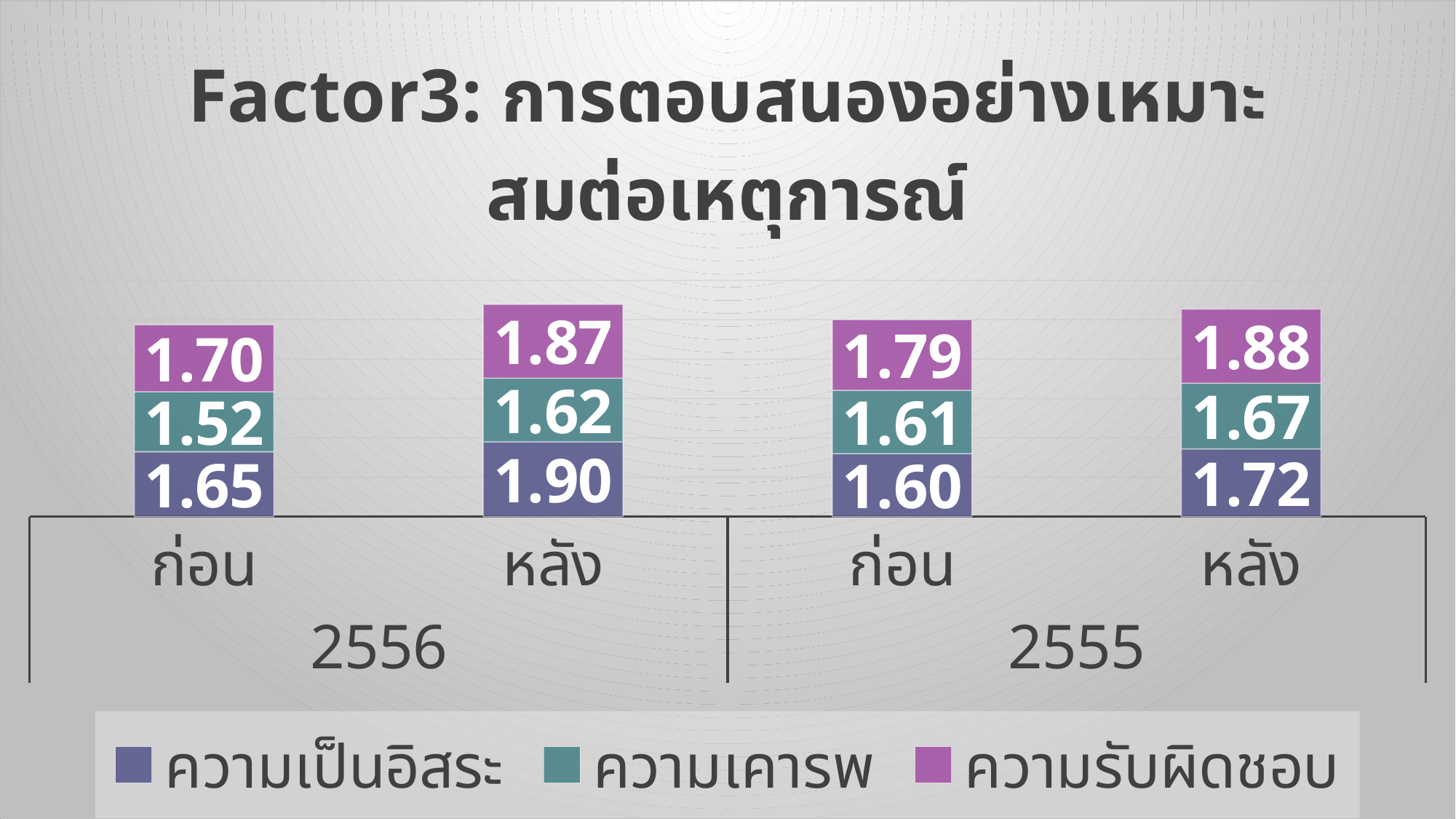
What is the difference between the ความเป็นอิสระ values for หลัง and ก่อน in 2556? 0.25 How many stacked bars are plotted in the chart? 4 What is the value of ความรับผิดชอบ for ก่อน in 2556? 1.70 What is the value of ความรับผิดชอบ for หลัง in 2555? 1.88 How many series does the legend list? 3 Which category has the lowest value for ความเคารพ? ก่อน 2556 What is the value of ความเป็นอิสระ for หลัง in 2556? 1.90 Which category has the highest value for ความเป็นอิสระ? หลัง 2556 What is the value of ความเคารพ for ก่อน in 2555? 1.61 Which is larger: ความรับผิดชอบ for ก่อน 2555 or ความรับผิดชอบ for ก่อน 2556? ก่อน 2555 What type of chart is shown on the slide? Stacked bar chart What is the total of the stacked bar for หลัง in 2556? 5.39